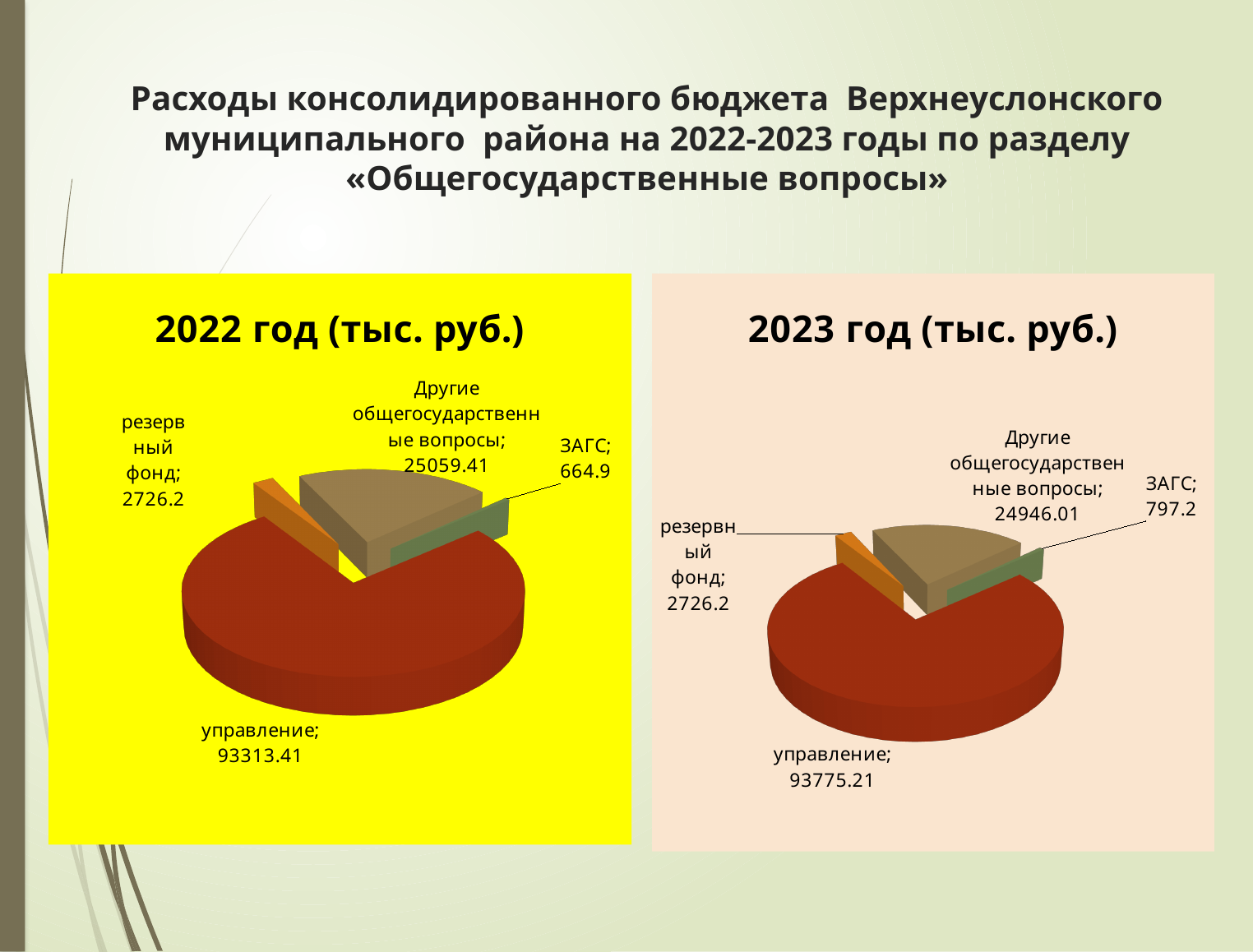
In the 2022 год (тыс. руб.) chart, what is the difference between управление and Другие общегосударственные вопросы? 68254 In the 2023 год (тыс. руб.) chart, what is the value for резервный фонд? 2726.2 What type of chart is the 2022 год (тыс. руб.) chart? Pie chart In the 2022 год (тыс. руб.) chart, which category has the largest value? управление In the 2022 год (тыс. руб.) chart, what is the value for управление? 93313.41 Which is larger: ЗАГС in the 2022 год chart or ЗАГС in the 2023 год chart? 2023 год (797.2) In the 2022 год (тыс. руб.) chart, what is the value for Другие общегосударственные вопросы? 25059.41 What is the difference between the ЗАГС value in the 2023 год chart and the ЗАГС value in the 2022 год chart? 132.3 In the 2023 год (тыс. руб.) chart, which category has the smallest value? ЗАГС In the 2023 год (тыс. руб.) chart, what is the value for ЗАГС? 797.2 What is the title of the chart on the right side of the slide? 2023 год (тыс. руб.) How many categories are shown in the 2023 год (тыс. руб.) chart? 4